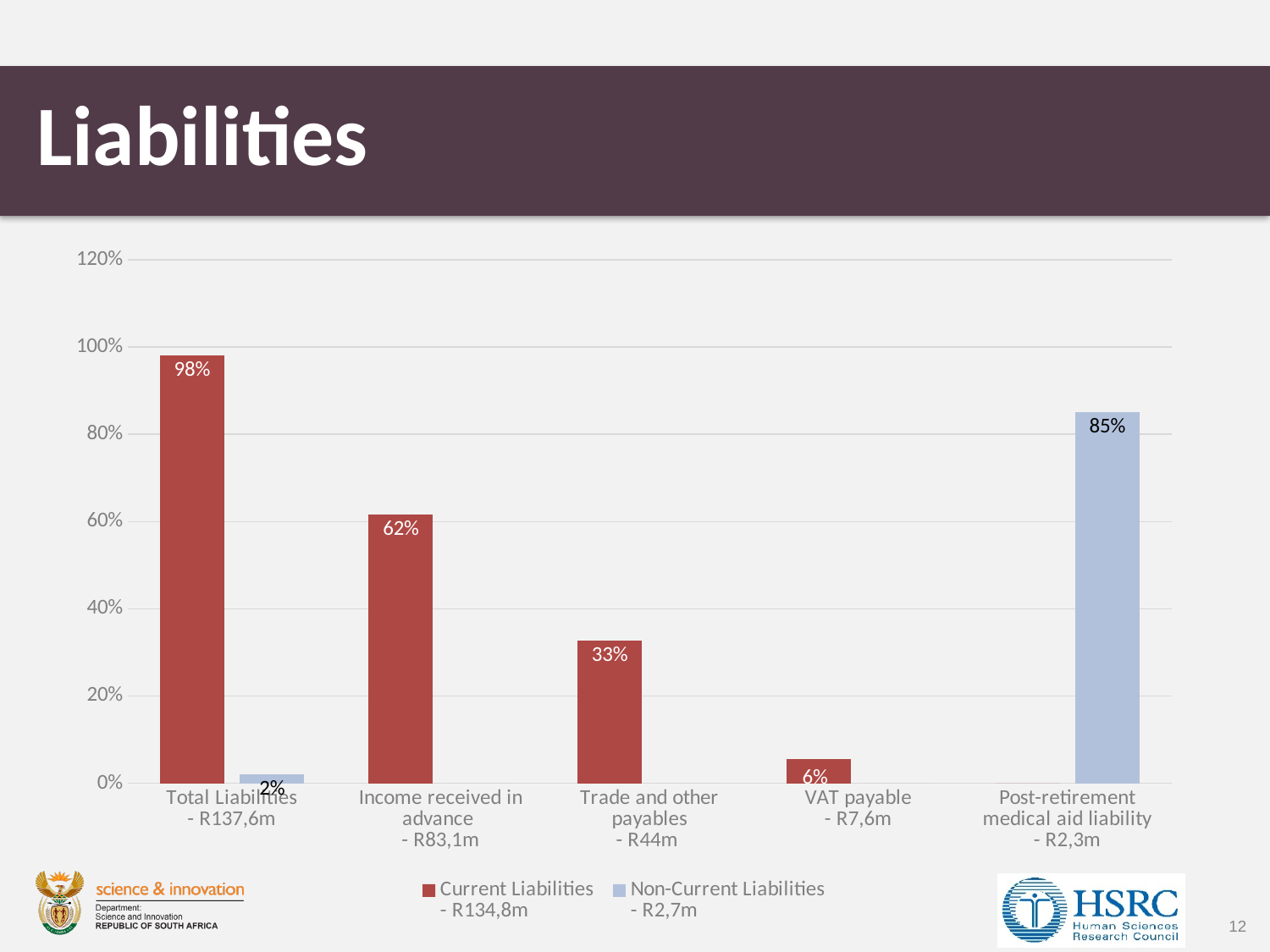
Which is larger: the Current Liabilities value for Total Liabilities or the Non-Current Liabilities value for Post-retirement medical aid liability? Current Liabilities value for Total Liabilities Which category has the highest Current Liabilities value? Total Liabilities What kind of chart is shown on the slide? Bar chart How many series does the legend list? 2 What is the Current Liabilities value for Income received in advance? 62% How many categories are shown on the x axis? 5 What is the Current Liabilities value for VAT payable? 6% Which category has the lowest Current Liabilities value among those with a Current Liabilities bar? VAT payable What is the Current Liabilities value for Trade and other payables? 33% What is the Non-Current Liabilities value for Total Liabilities? 2% What is the Non-Current Liabilities value for Post-retirement medical aid liability? 85% What is the difference between the Current Liabilities values for Income received in advance and Trade and other payables? 29%